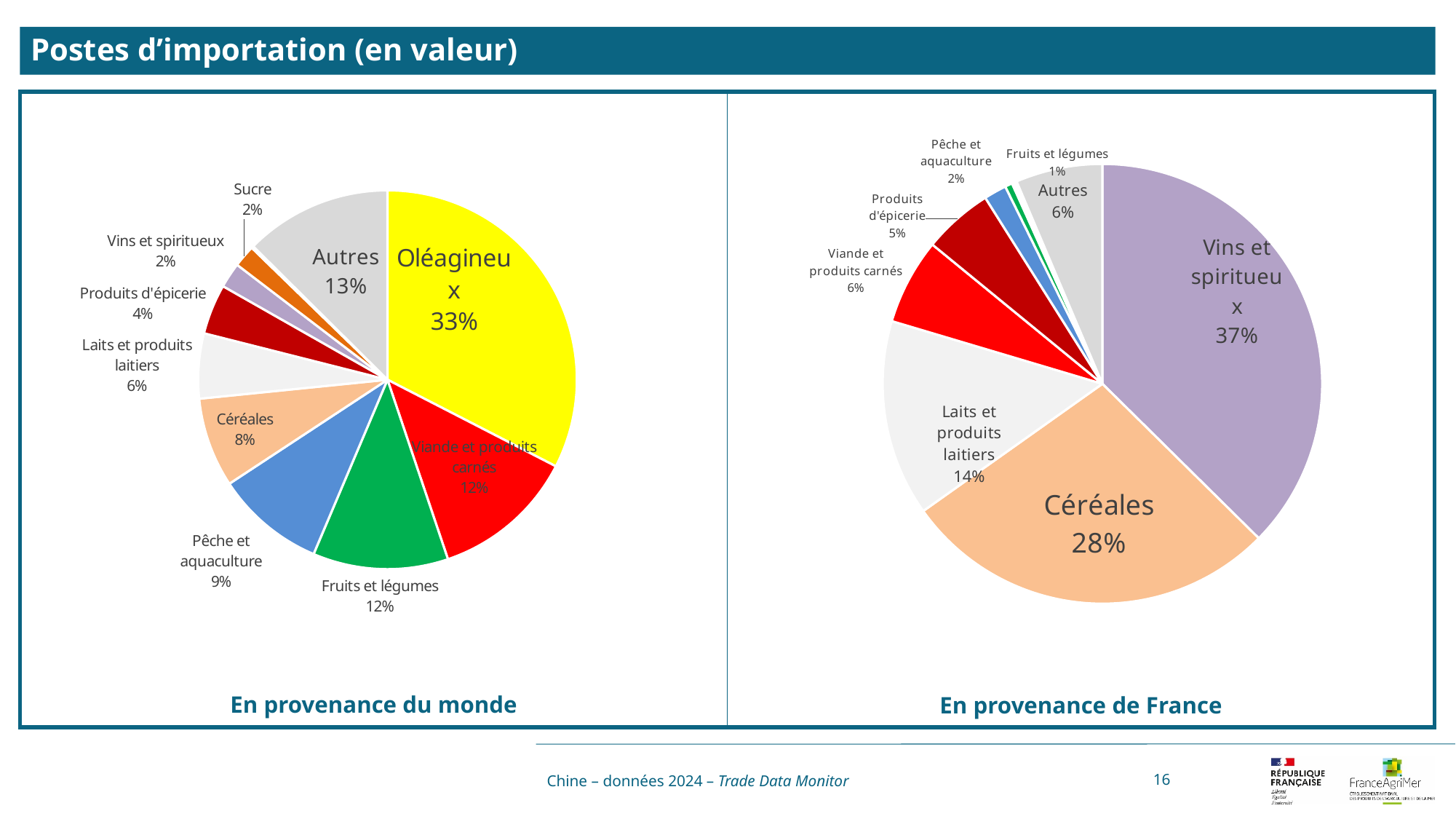
In the 'En provenance du monde' chart, what share does Sucre represent? 2% In the 'En provenance de France' chart, what share do Céréales represent? 28% In the 'En provenance de France' chart, what is the difference in percentage points between Vins et spiritueux and Céréales? 9 In the 'En provenance de France' chart, what share do Laits et produits laitiers represent? 14% How many slices does the 'En provenance de France' pie chart have? 8 In the 'En provenance de France' chart, which category has the smallest share? Fruits et légumes What type of chart is used on this slide? Pie chart How many slices does the 'En provenance du monde' pie chart have? 10 In the 'En provenance du monde' chart, what share do Oléagineux represent? 33% In the 'En provenance du monde' chart, which category has the largest share? Oléagineux In the 'En provenance du monde' chart, which is larger: Pêche et aquaculture or Céréales? Pêche et aquaculture What is the title of the slide? Postes d'importation (en valeur)